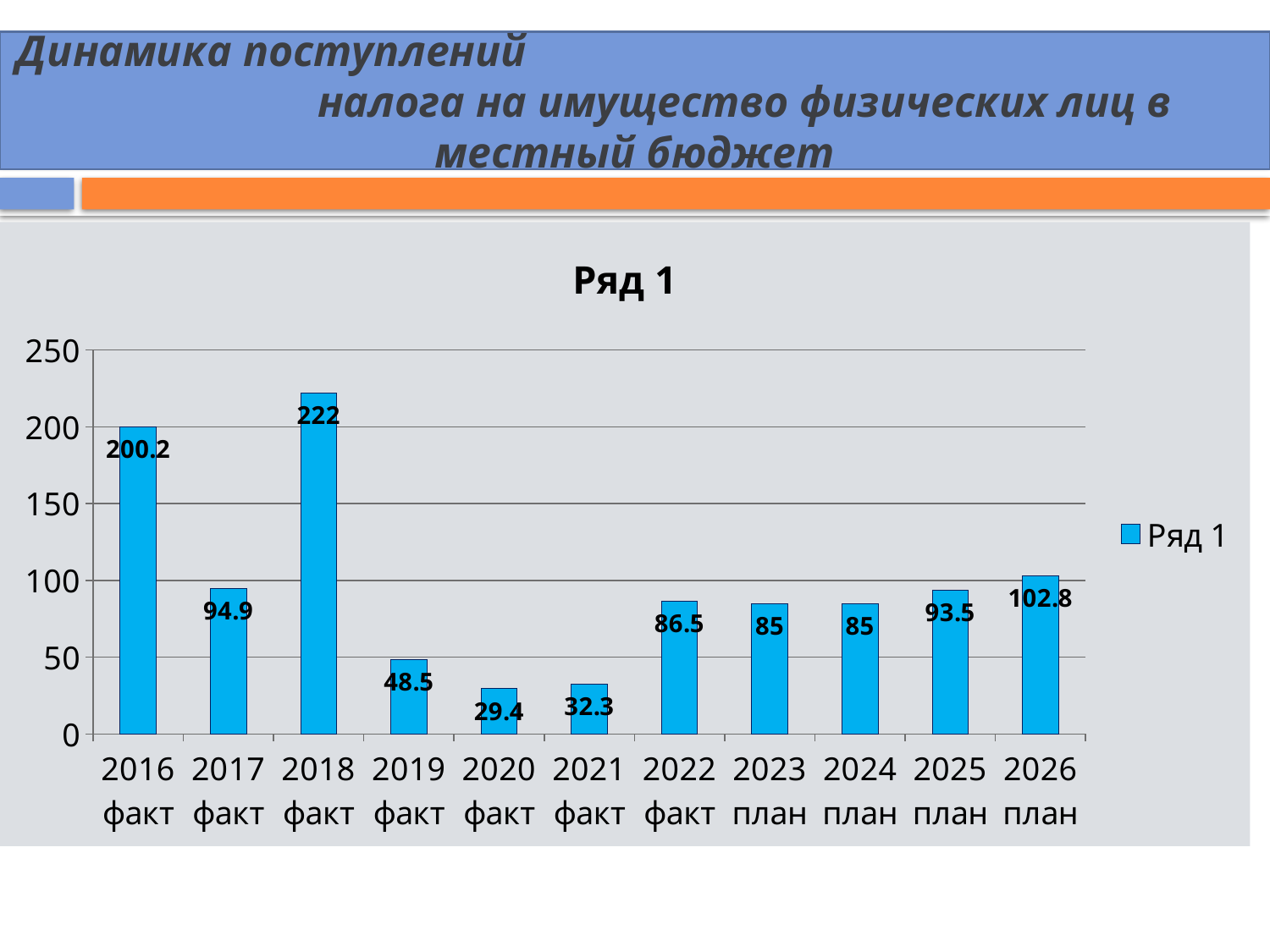
Is the value for 2022 факт greater or less than 100? less How many series does the legend list? 1 What is the difference between the values for 2018 факт and 2016 факт? 21.8 What is the value for 2018 факт? 222 What is the value for 2026 план? 102.8 What is the value for 2020 факт? 29.4 What kind of chart is shown on the slide? bar chart Do the values rise or fall from 2023 план to 2026 план? rise How many categories are shown on the x axis? 11 Which category has the highest value? 2018 факт Which is larger, the value for 2017 факт or the value for 2025 план? 2017 факт Which category has the lowest value? 2020 факт